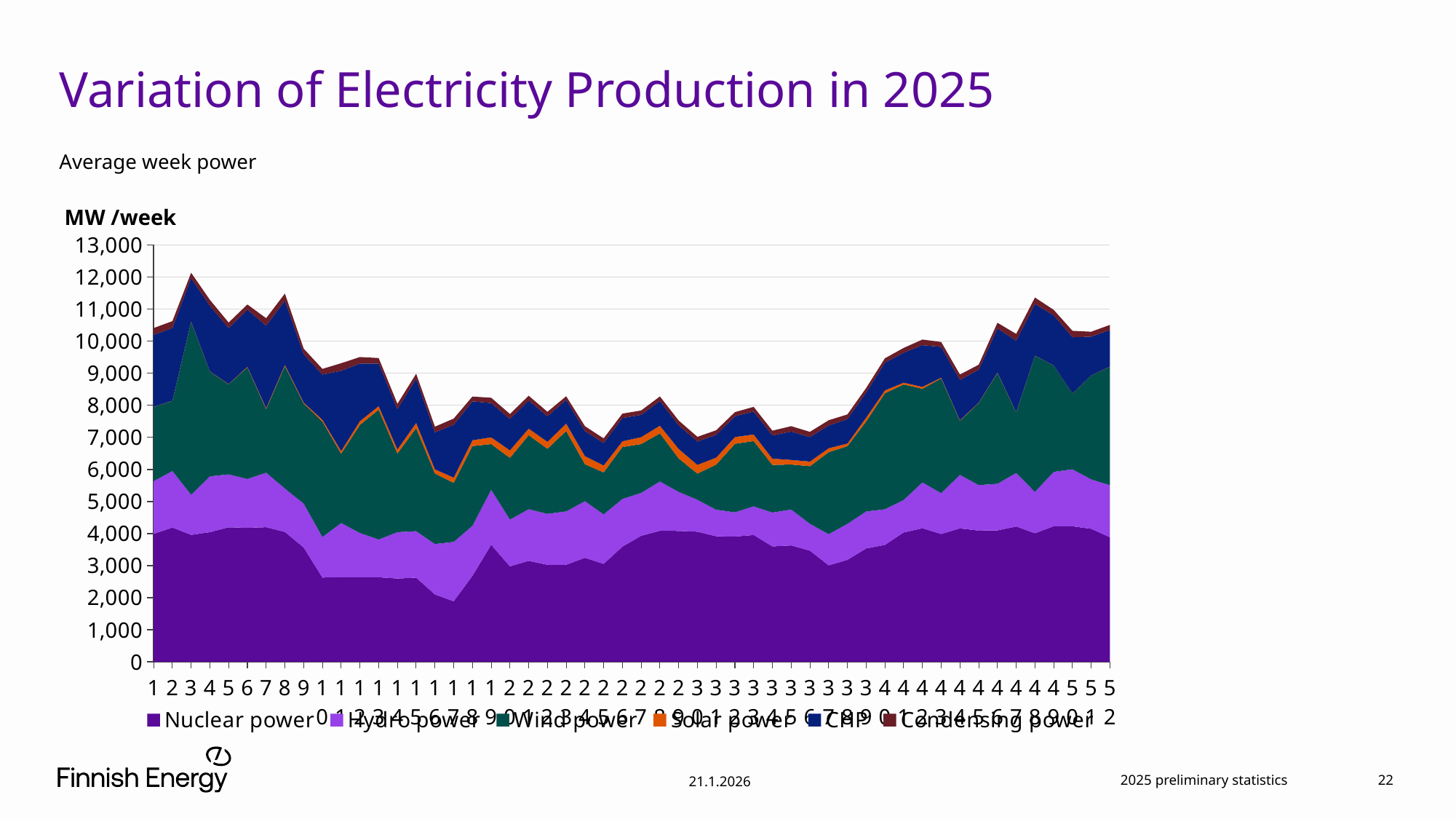
Which series is plotted at the bottom of the stack? Nuclear power Is the total production in week 17 greater or less than 7,000? greater What unit is shown on the y-axis label? MW /week Is the total production in week 3 greater or less than 11,000? greater Is the value for Nuclear power in week 1 greater or less than 3,000? greater What is the title of the chart on the slide? Variation of Electricity Production in 2025 In which week is the total electricity production highest? Week 3 How many weeks are plotted along the x-axis? 52 How many series does the legend list? 6 Does the total production rise or fall from week 3 to week 17? fall What kind of chart is shown on the slide? Stacked area chart